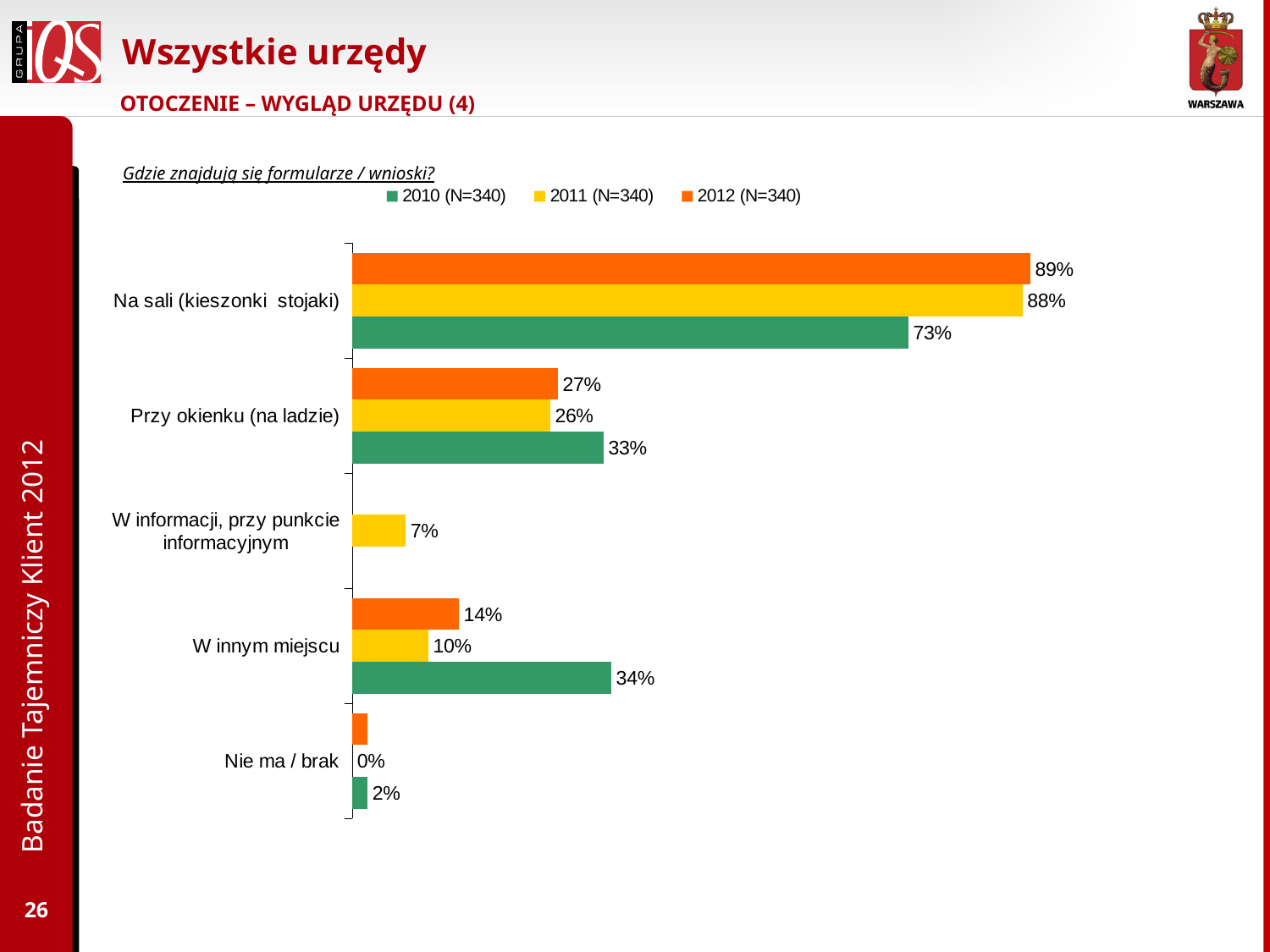
Which colour represents the 2012 (N=340) series in the legend? orange For 'W innym miejscu', which is larger: the value for 2010 (N=340) or for 2012 (N=340)? 2010 (N=340) How many categories are shown on the chart? 5 Which category has the highest value for 2011 (N=340)? Na sali (kieszonki stojaki) What is the value for 2011 (N=340) in the category 'W informacji, przy punkcie informacyjnym'? 7% What is the value for 2012 (N=340) in the category 'Na sali (kieszonki stojaki)'? 89% What kind of chart is shown on the slide? bar chart What is the difference between the 2012 (N=340) and 2010 (N=340) values for 'Na sali (kieszonki stojaki)'? 16% Which category has the lowest value for 2010 (N=340)? Nie ma / brak What is the value for 2010 (N=340) in the category 'Przy okienku (na ladzie)'? 33% What is the value for 2010 (N=340) in the category 'W innym miejscu'? 34% How many series does the legend list? 3